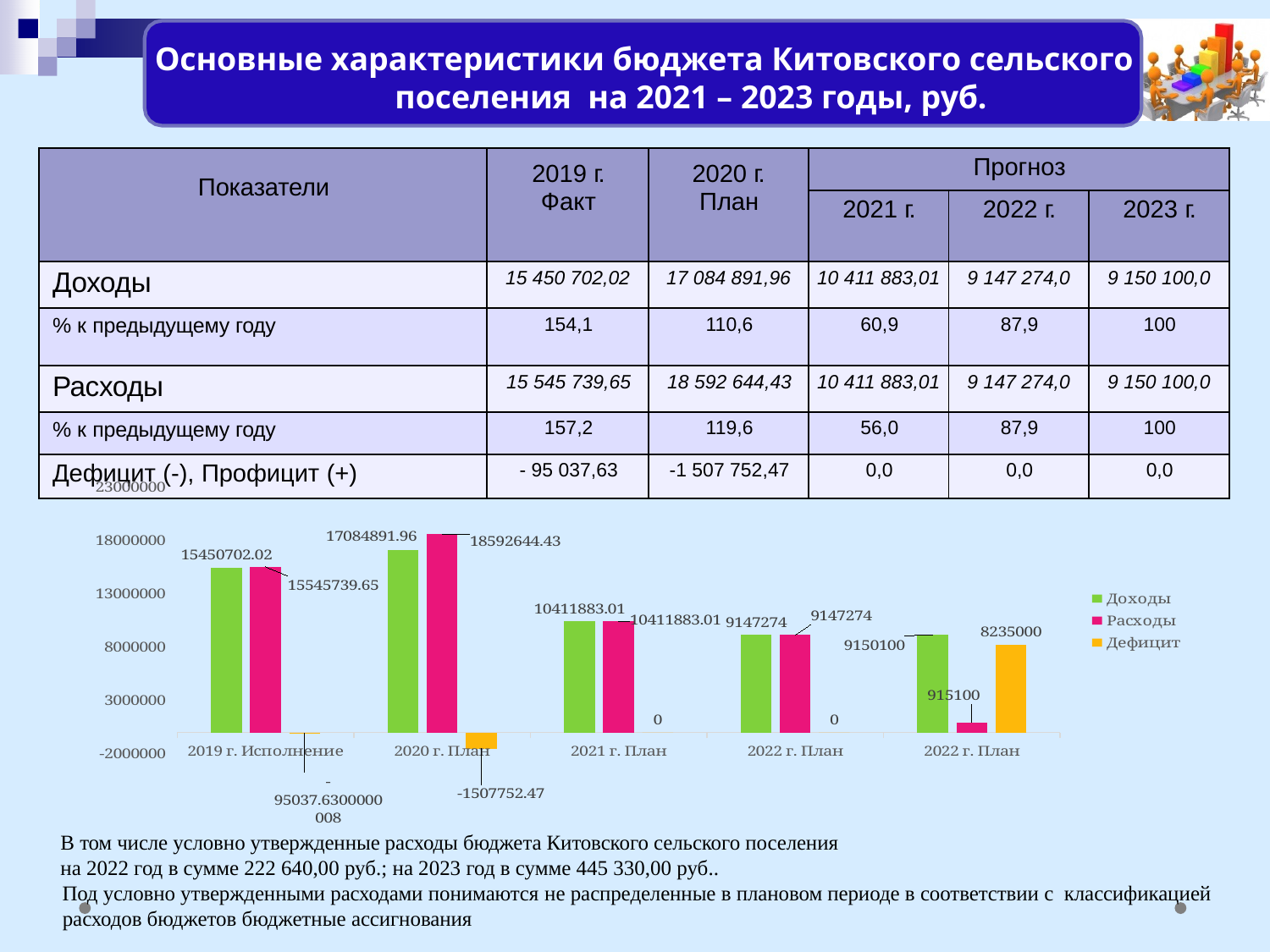
For 2020 г. План, which is larger in the chart: Доходы or Расходы? Расходы What is the value of Дефицит for 2020 г. План in the chart? -1507752.47 What is the value of Доходы for 2020 г. План in the chart? 17084891.96 What kind of chart is shown below the table on the slide? bar chart What are the series names listed in the chart legend? Доходы, Расходы, Дефицит What is the value of Доходы for 2019 г. Исполнение in the chart? 15450702.02 What is the difference between Расходы and Доходы for 2020 г. План in the chart? 1507752.47 How many categories are shown along the x axis of the chart? 5 What is the value of Расходы for 2020 г. План in the chart? 18592644.43 How many series does the chart legend list? 3 Which category has the highest Расходы value in the chart? 2020 г. План Is the Доходы value for 2021 г. План greater or less than 13000000? less